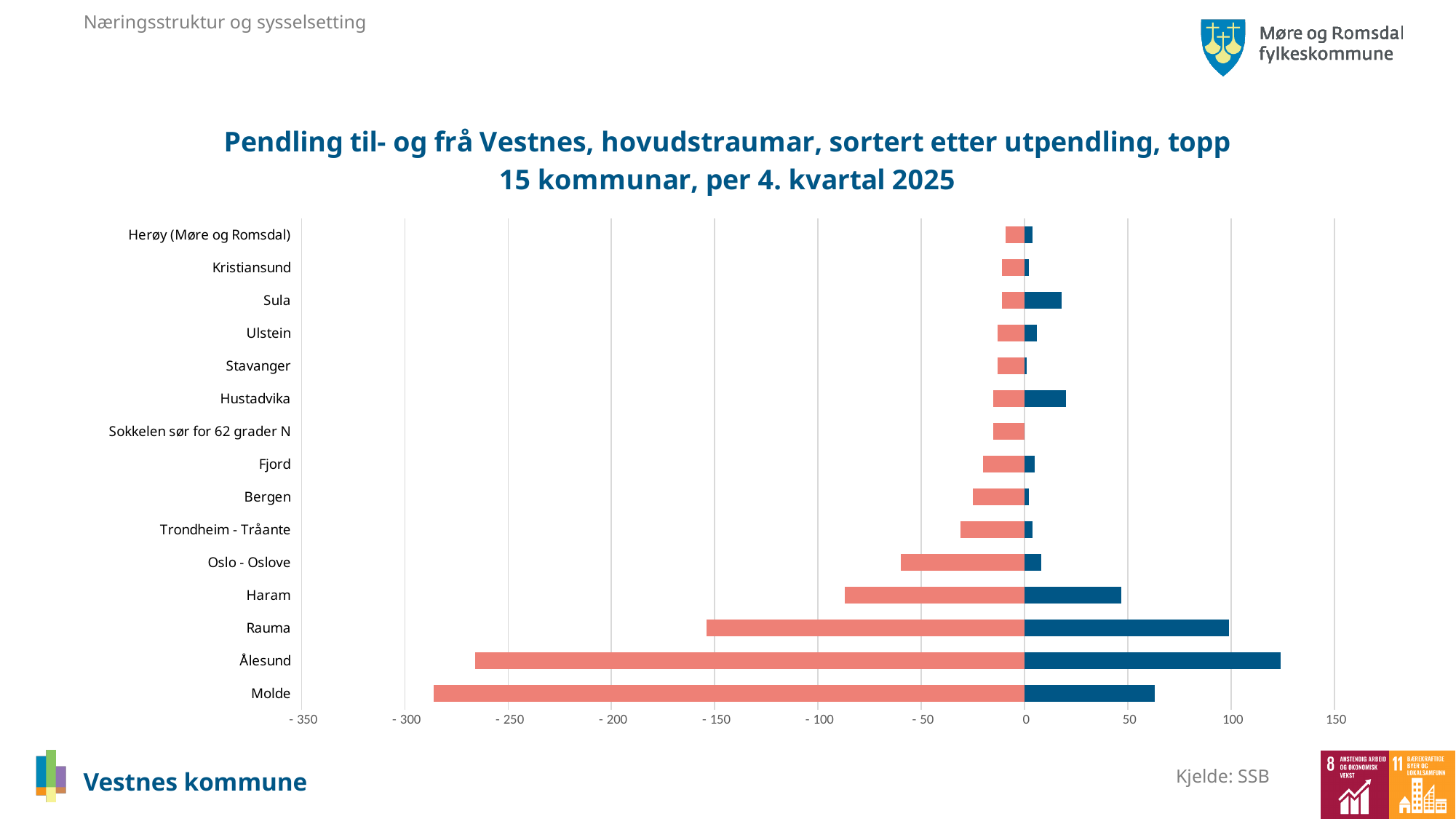
Is the blue bar value for Molde greater or less than 50? greater Is the blue bar value for Ålesund greater or less than 100? greater Which category has the longest blue bar (largest positive value)? Ålesund Is the red bar value for Haram greater or less than -100? greater Which has the longer blue bar, Rauma or Haram? Rauma Which category shows only a red bar and no blue bar? Sokkelen sør for 62 grader N How many municipalities (categories) are listed on the chart? 15 Which has the longer red bar, Molde or Ålesund? Molde Which category has the longest red bar (most negative value)? Molde What kind of chart is shown on the slide? bar chart